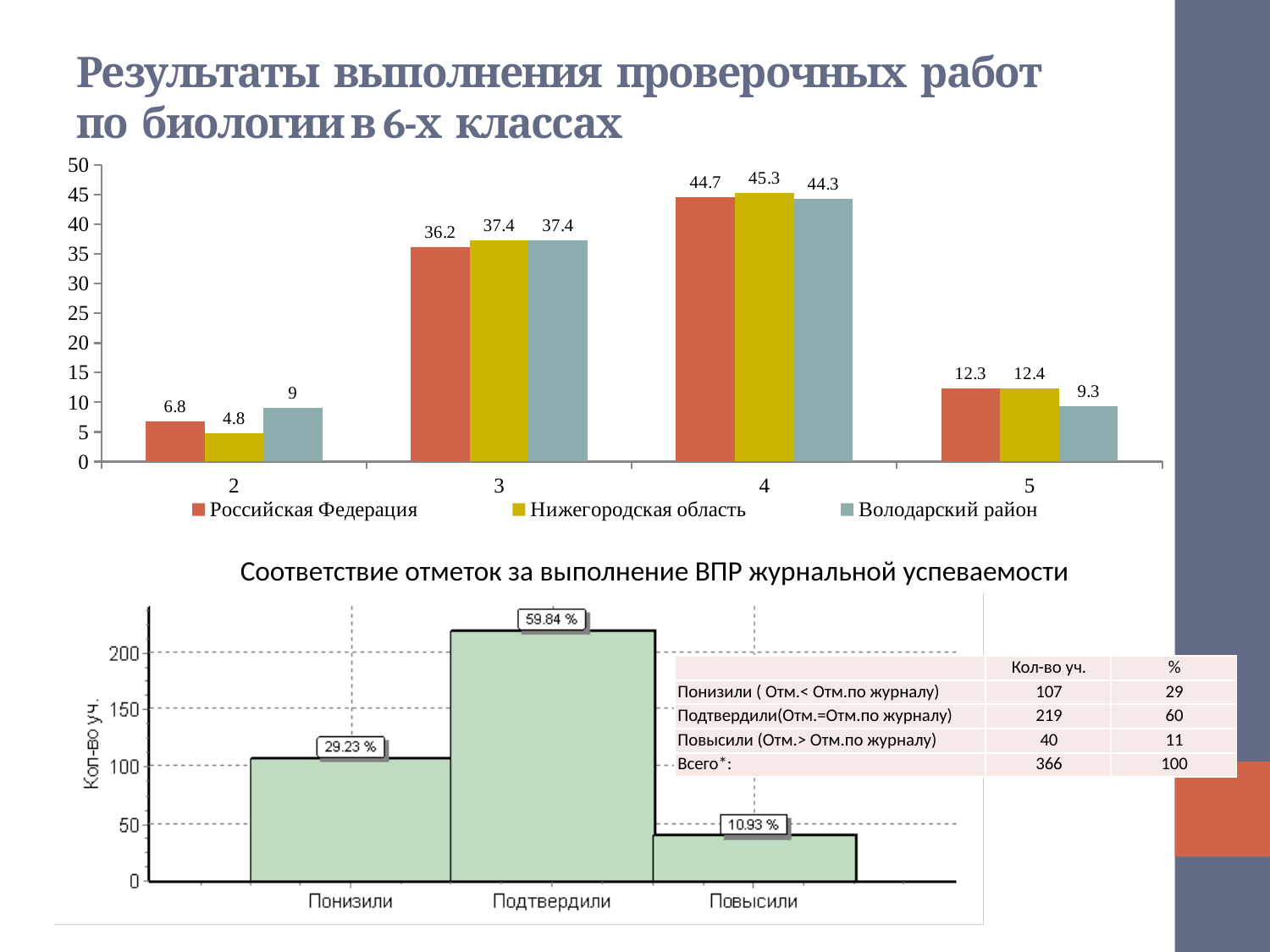
In the chart titled 'Соответствие отметок за выполнение ВПР журнальной успеваемости', is the value for Повысили greater or less than 50? less In the top chart, which category has the highest value for Нижегородская область? 4 In the top chart, what is the difference between Нижегородская область and Российская Федерация at category 3? 1.2 What kind of chart is the chart titled 'Соответствие отметок за выполнение ВПР журнальной успеваемости'? bar chart In the top chart, what is the value for Володарский район at category 2? 9 In the chart titled 'Соответствие отметок за выполнение ВПР журнальной успеваемости', what percentage is shown for Подтвердили? 59.84 % In the top chart, at category 5, which is larger: Российская Федерация or Володарский район? Российская Федерация How many series does the legend of the top chart list? 3 In the top chart, what is the value for Нижегородская область at category 5? 12.4 In the top chart, which category has the lowest value for Российская Федерация? 2 In the top chart, what is the value for Российская Федерация at category 4? 44.7 How many categories are shown on the x axis of the top chart? 4